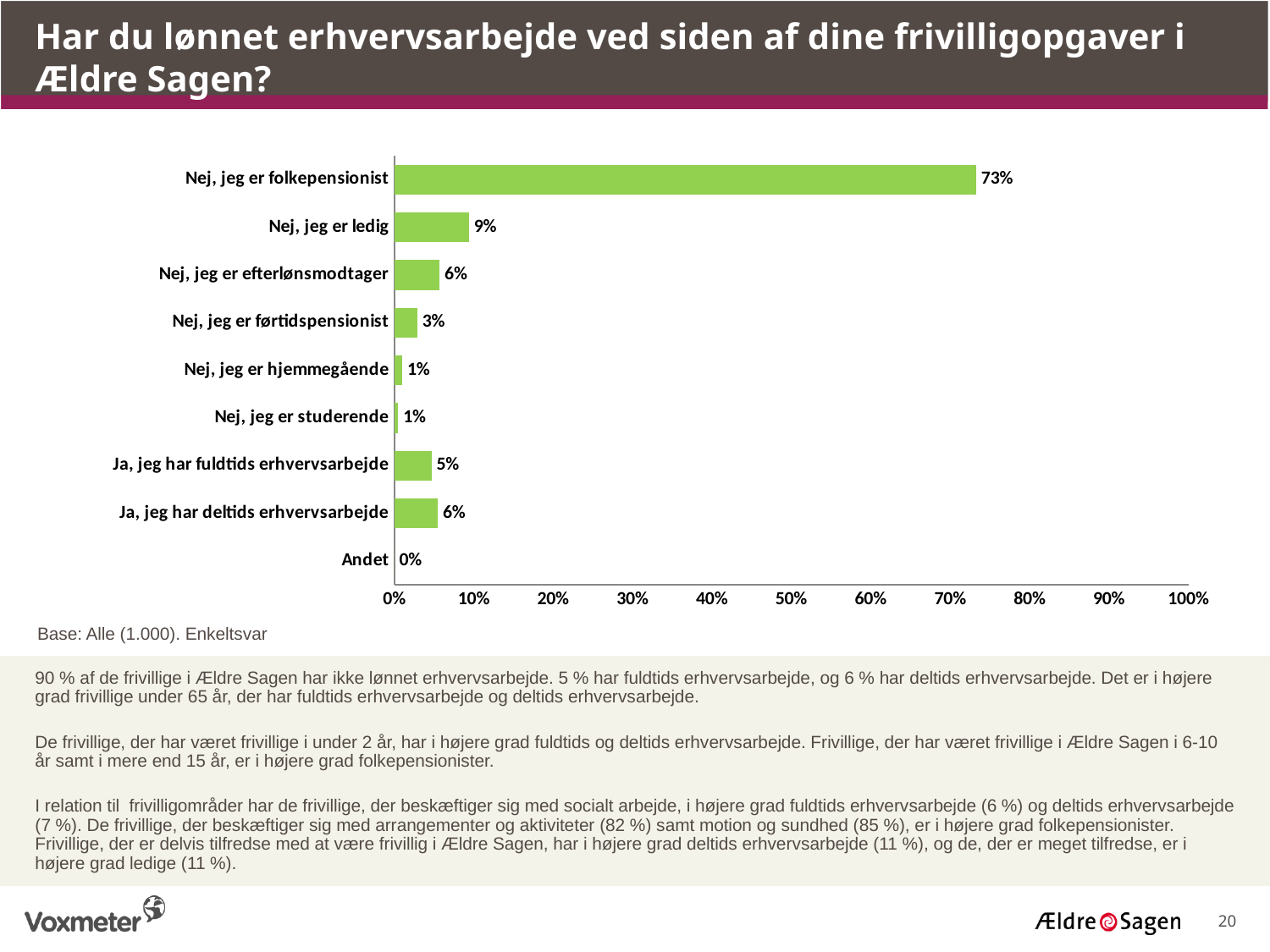
What is the value for "Ja, jeg har fuldtids erhvervsarbejde"? 5% What is the value for "Nej, jeg er folkepensionist"? 73% Which is larger: "Nej, jeg er efterlønsmodtager" or "Nej, jeg er førtidspensionist"? Nej, jeg er efterlønsmodtager Is the value for "Nej, jeg er folkepensionist" greater or less than 70%? greater What is the value for "Nej, jeg er ledig"? 9% What kind of chart is shown on the slide? bar chart Which category has the highest value? Nej, jeg er folkepensionist What is the value for "Andet"? 0% What is the difference between "Nej, jeg er folkepensionist" and "Nej, jeg er ledig"? 64% Which category has the lowest value? Andet What is the base stated below the chart? Alle (1.000). Enkeltsvar How many categories are shown in the chart? 9